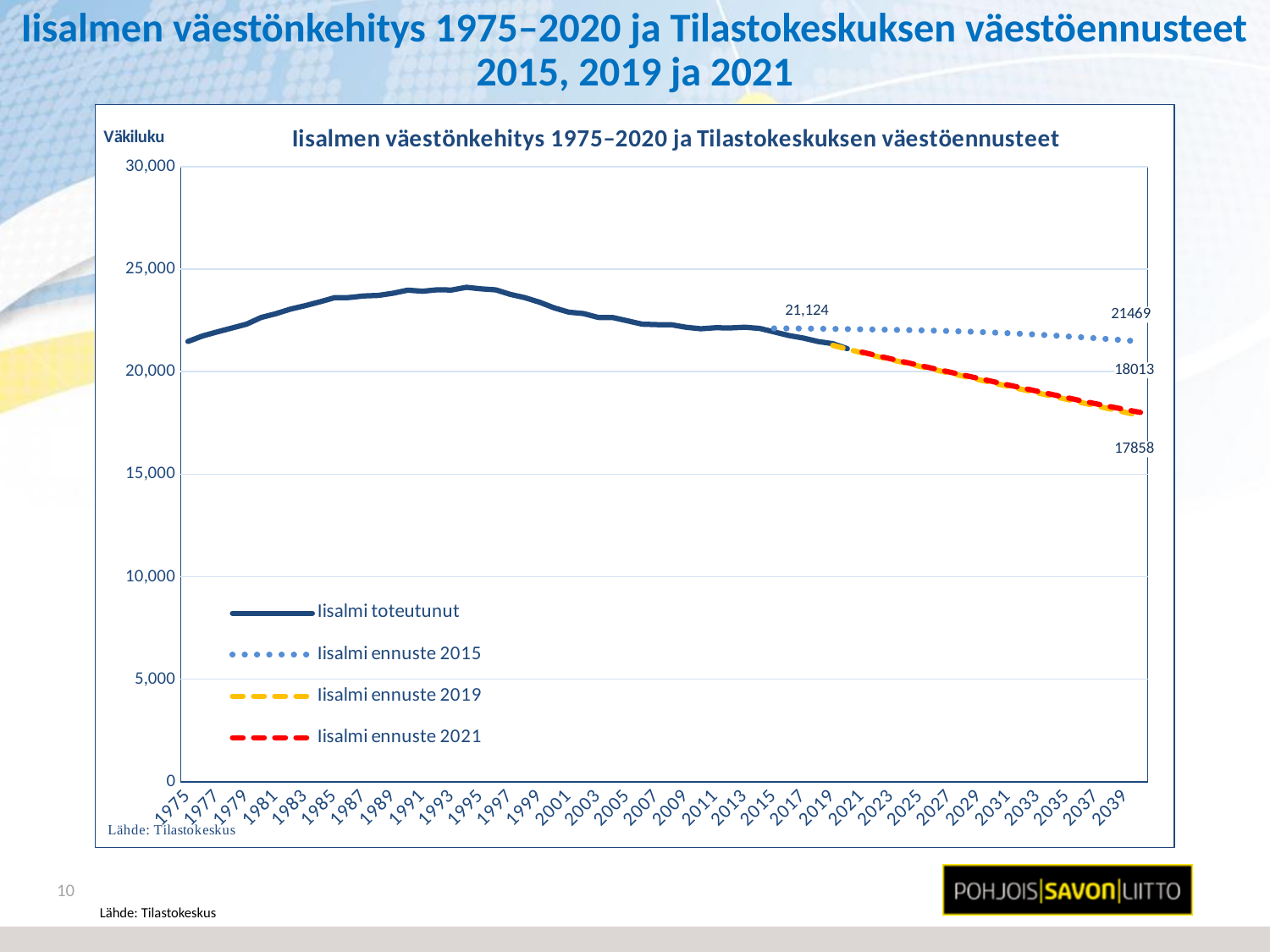
How many series does the chart legend list? 4 What are the four series listed in the chart legend? Iisalmi toteutunut, Iisalmi ennuste 2015, Iisalmi ennuste 2019, Iisalmi ennuste 2021 Is the Iisalmi toteutunut value for 1995 greater or less than 20,000? greater Which forecast ends higher in 2039, Iisalmi ennuste 2015 or Iisalmi ennuste 2021? Iisalmi ennuste 2015 Does the Iisalmi toteutunut line rise or fall between 1995 and 2020? fall What is the difference between the highest (21469) and lowest (17858) data labels at the right end of the chart? 3611 What is the data label at the right end of the Iisalmi ennuste 2015 line? 21469 What type of chart is shown on the slide? line chart What is the label on the vertical axis of the chart? Väkiluku Is the Iisalmi ennuste 2021 value for 2039 greater or less than 20,000? less What value is printed as a data label near the year 2015 on the chart? 21,124 What is the lowest data label printed at the right end of the chart? 17858